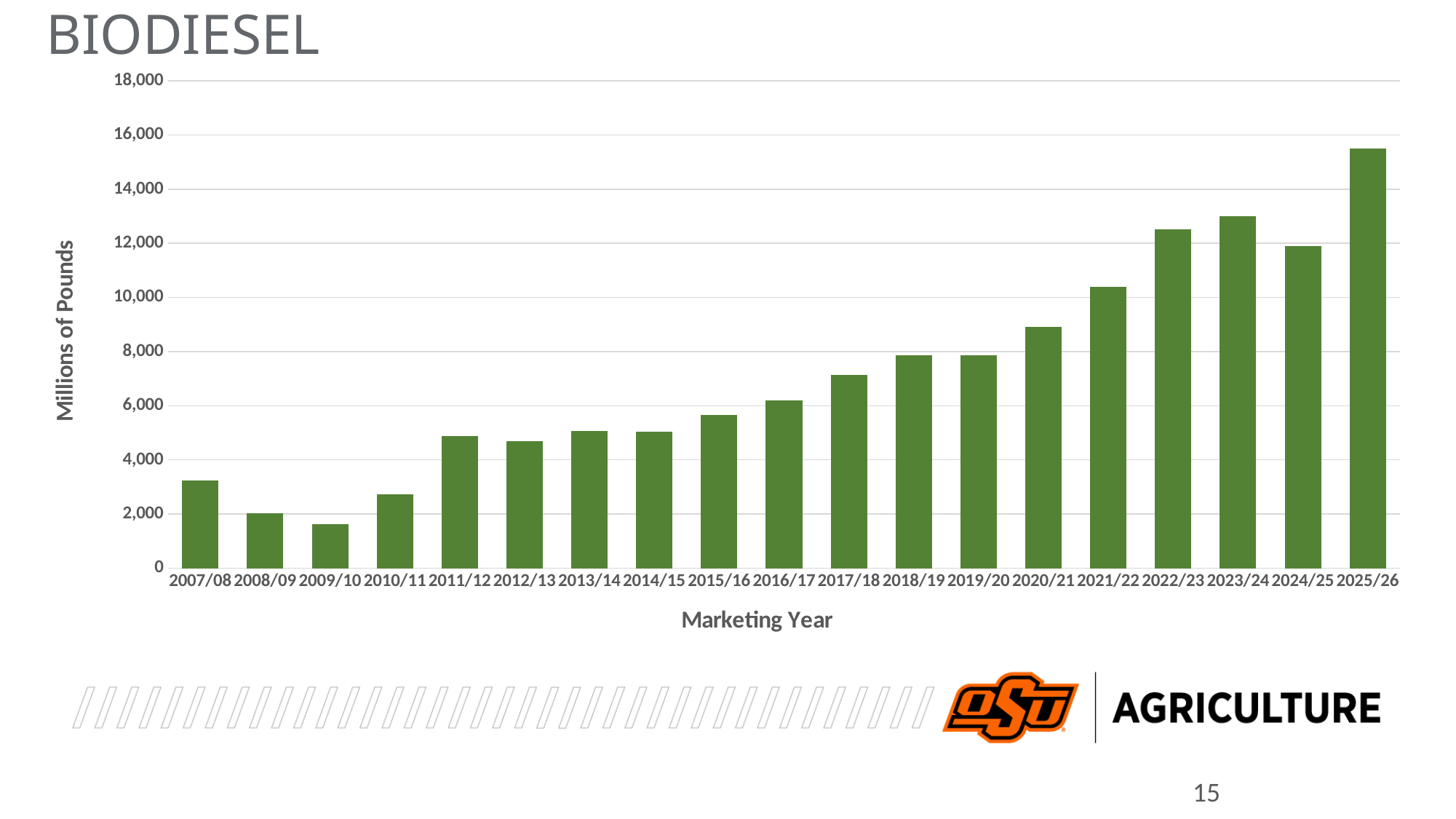
What kind of chart is shown on the slide? bar chart Is the value for 2025/26 greater or less than 14,000? greater Which is larger, the value for 2007/08 or the value for 2008/09? 2007/08 Is the value for 2009/10 greater or less than 2,000? less How many marketing years are plotted on the chart? 19 What is the label on the vertical axis? Millions of Pounds Is the value for 2021/22 greater or less than 10,000? greater Do the values generally rise or fall from 2009/10 to 2025/26? rise Which marketing year has the lowest value? 2009/10 Which marketing year has the highest value? 2025/26 Which is larger, the value for 2023/24 or the value for 2024/25? 2023/24